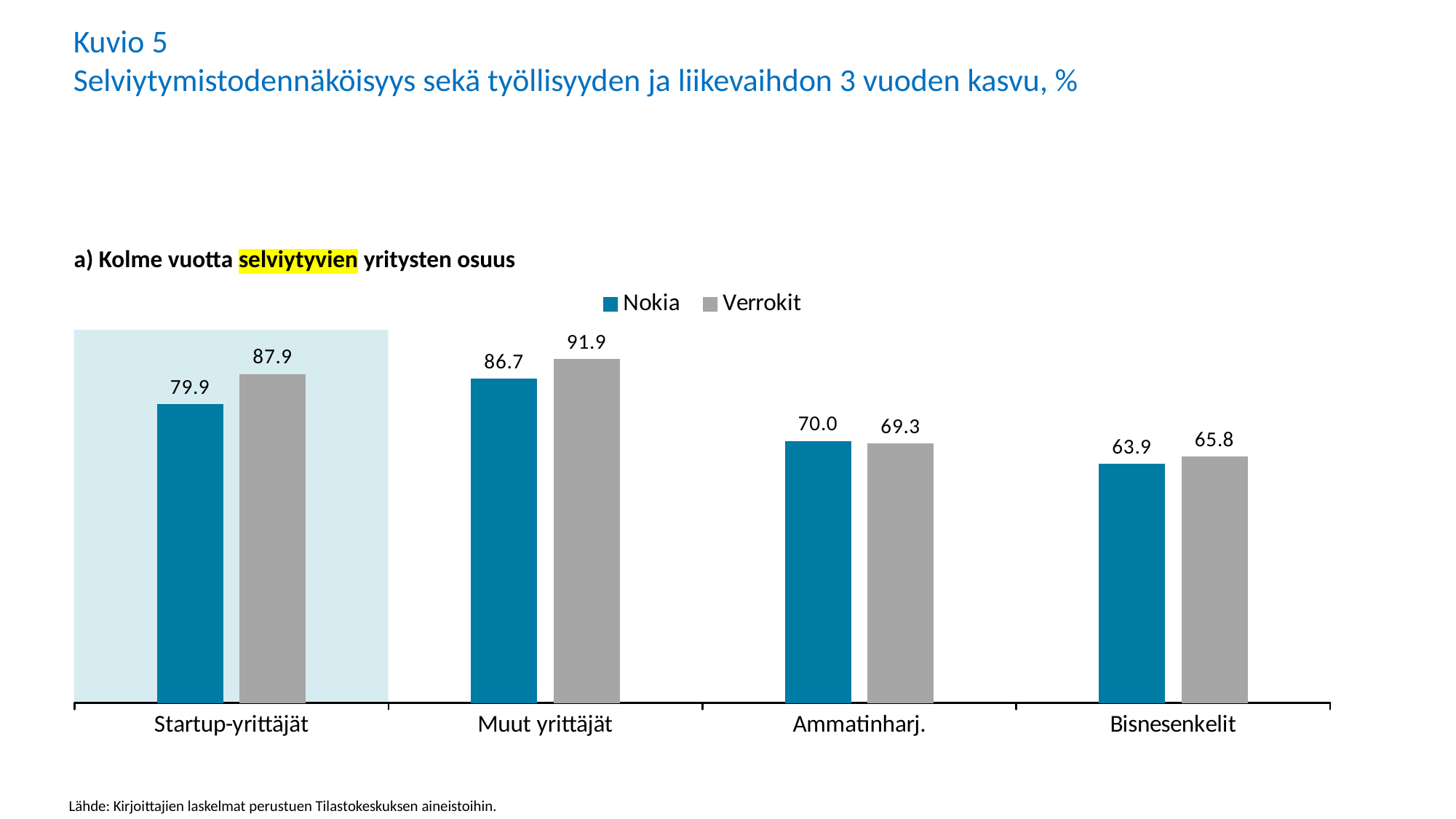
What is the difference between the Nokia values for Muut yrittäjät and Bisnesenkelit? 22.8 What is the Verrokit value for Muut yrittäjät? 91.9 What kind of chart is shown? Bar chart What is the Nokia value for Ammatinharj.? 70.0 Which is larger for Ammatinharj., the Nokia value or the Verrokit value? Nokia How many categories are shown on the x axis? 4 What is the Nokia value for Startup-yrittäjät? 79.9 Which category has the lowest Nokia value? Bisnesenkelit Which category has the highest Verrokit value? Muut yrittäjät What is the Verrokit value for Bisnesenkelit? 65.8 How many series does the legend list? 2 What is the difference between the Verrokit and Nokia values for Startup-yrittäjät? 8.0